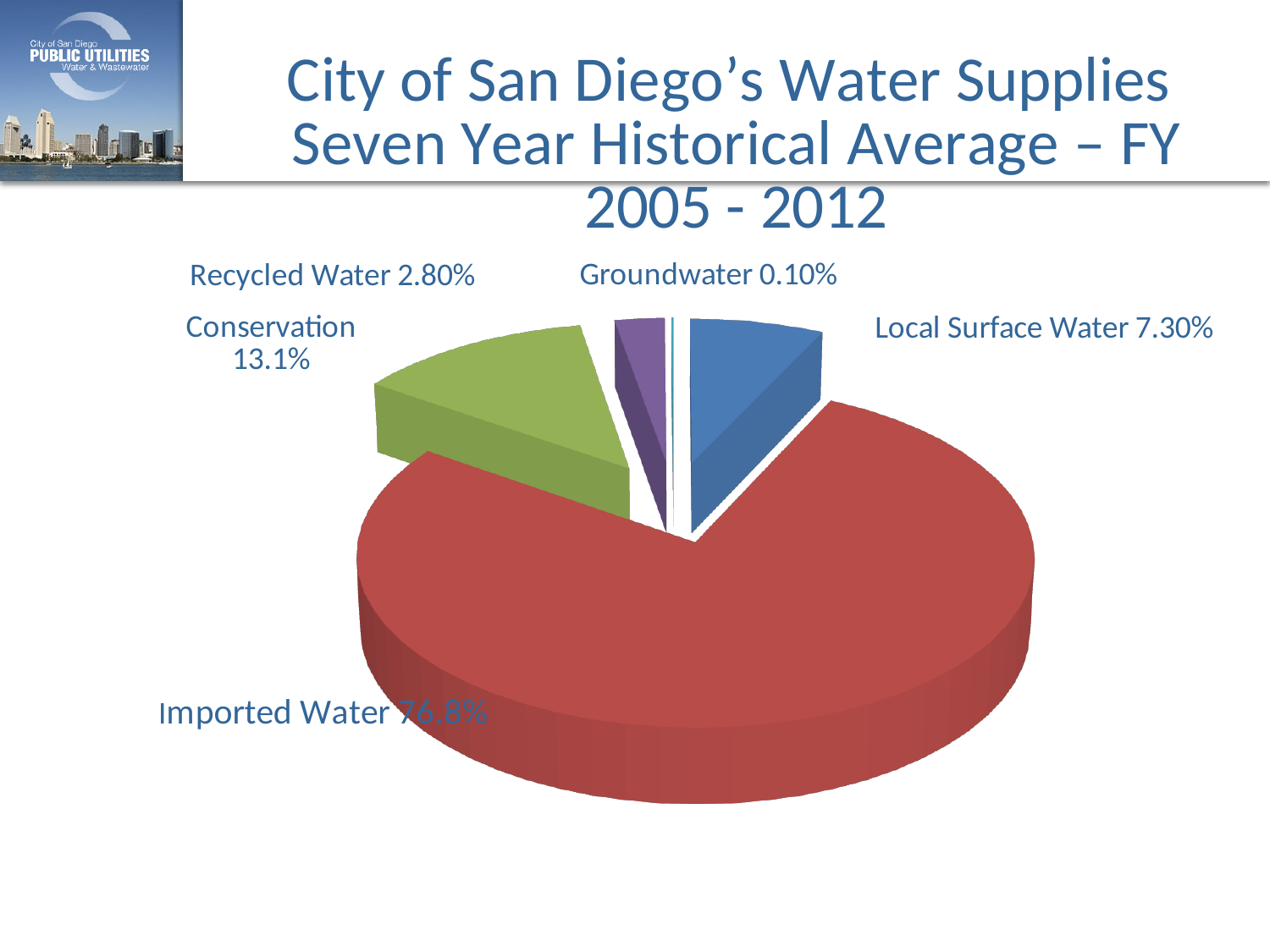
What percentage is shown for Conservation? 13.1% Which water supply source has the largest share of the pie? Imported Water What kind of chart is shown on the slide? Pie chart What is the difference in percentage points between Imported Water and Conservation? 63.7 How many slices does the pie chart have? 5 What colour is the Imported Water slice? Red What share of the City of San Diego's water supplies is Imported Water? 76.8% What percentage is shown for Groundwater? 0.10% Which is larger, the share for Conservation or the share for Local Surface Water? Conservation Which water supply source has the smallest share of the pie? Groundwater What percentage is shown for Local Surface Water? 7.30% What percentage is shown for Recycled Water? 2.80%